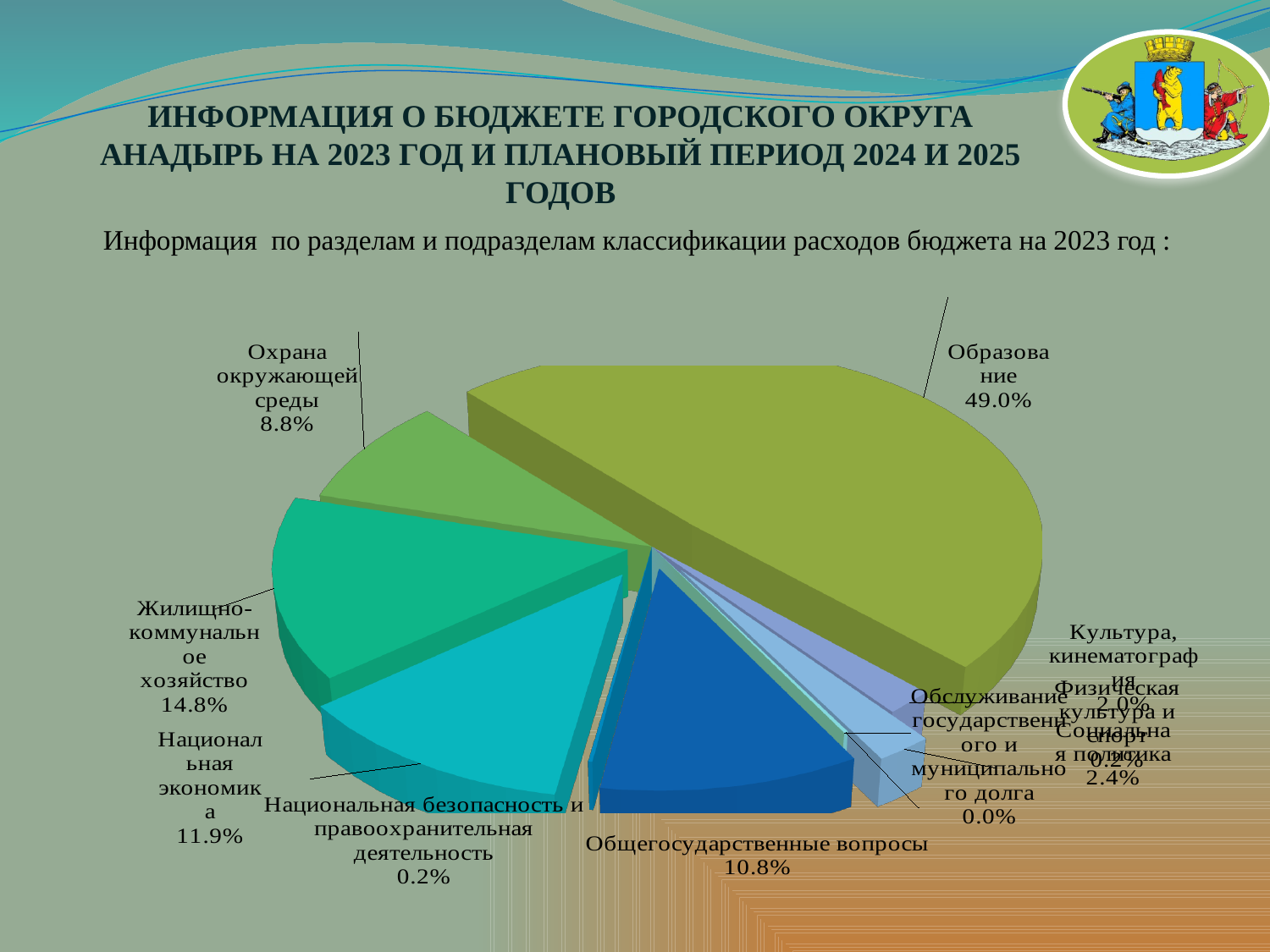
Which category has the largest slice of the pie? Образование What is the value for Общегосударственные вопросы? 10.8% What is the difference between the shares of Образование and Жилищно-коммунальное хозяйство? 34.2% Which is larger: the share for Национальная экономика or for Общегосударственные вопросы? Национальная экономика Which category has the smallest share of the pie? Обслуживание государственного и муниципального долга What value is labelled for Обслуживание государственного и муниципального долга? 0.0% What share of the pie does Образование account for? 49.0% What percentage is labelled for Национальная экономика? 11.9% What year does the chart's subtitle say the budget expenditure information refers to? 2023 What type of chart is shown on the slide? Pie chart What share is shown for Охрана окружающей среды? 8.8% What is the value shown for Жилищно-коммунальное хозяйство? 14.8%